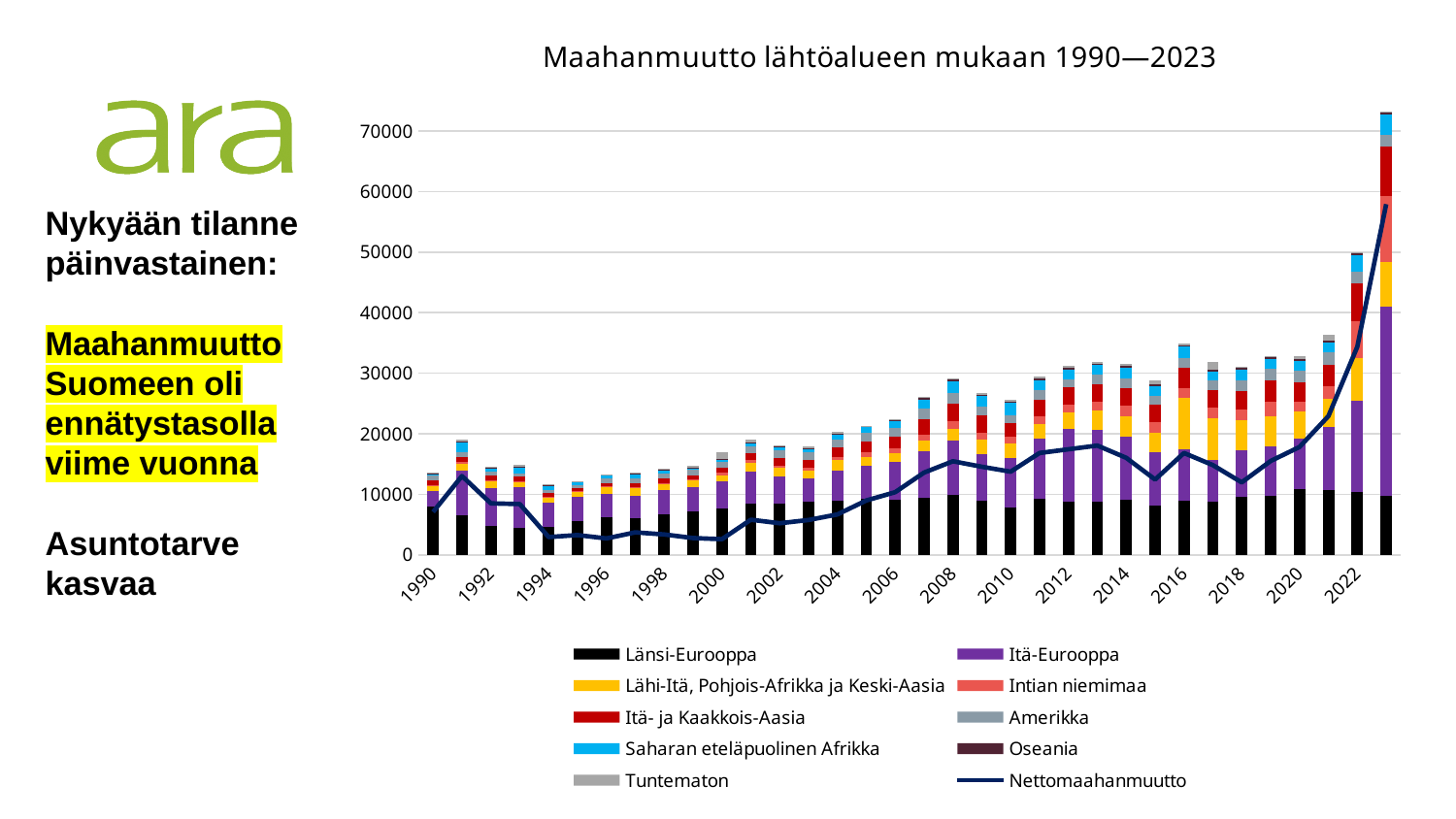
How many series does the legend list? 10 How many years (bars) are plotted on the x axis? 34 Which series is plotted as a line rather than as bars? Nettomaahanmuutto What kind of chart is shown on the slide? Stacked bar chart with a line Is the total immigration bar for 1990 greater or less than 20000? less Is the Nettomaahanmuutto line value for 2023 greater or less than 50000? greater What is the title of the chart? Maahanmuutto lähtöalueen mukaan 1990—2023 Which is larger, the total immigration bar for 2023 or for 1990? 2023 Is the Nettomaahanmuutto line value for 1994 greater or less than 10000? less Do the total immigration bars generally rise or fall from 1990 to 2023? rise Which year has the highest total immigration bar? 2023